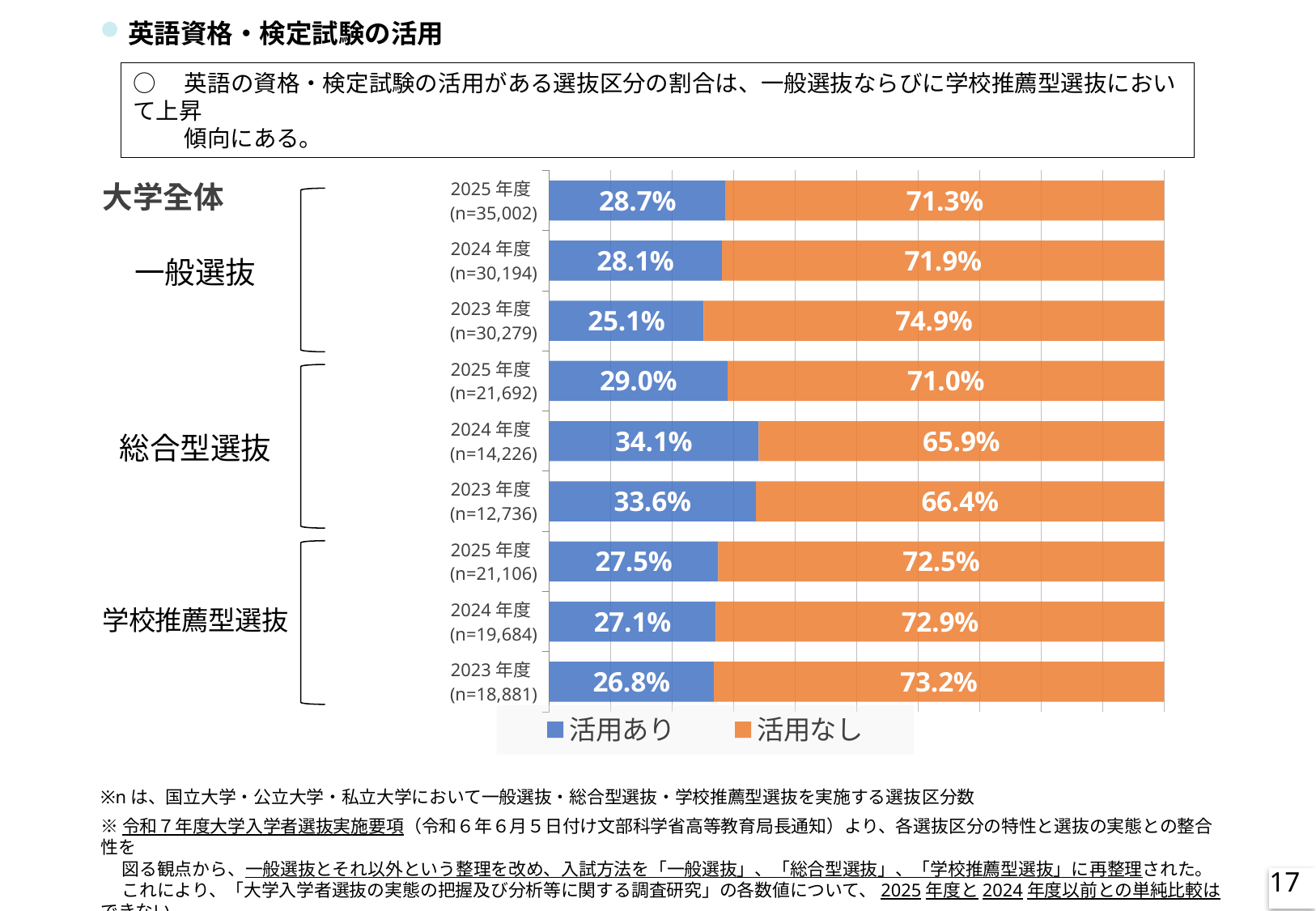
Does the 活用あり value for 学校推薦型選抜 rise or fall from 2023年度 to 2025年度? rise What is the sample size (n) shown for 一般選抜 in 2025年度? 35,002 Which bar has the highest 活用あり value? 総合型選抜 2024年度 Which is larger: the 活用あり value for 総合型選抜 in 2025年度 or for 学校推薦型選抜 in 2025年度? 総合型選抜 2025年度 What kind of chart is shown on the slide? stacked bar chart How many bars are plotted in the chart? 9 What is the 活用なし value for 総合型選抜 in 2024年度? 65.9% Which bar has the lowest 活用あり value? 一般選抜 2023年度 What is the difference between the 活用あり values for 一般選抜 in 2025年度 and 2023年度? 3.6% How many series does the legend list? 2 What is the 活用あり value for 一般選抜 in 2025年度? 28.7% What is the 活用あり value for 学校推薦型選抜 in 2023年度? 26.8%